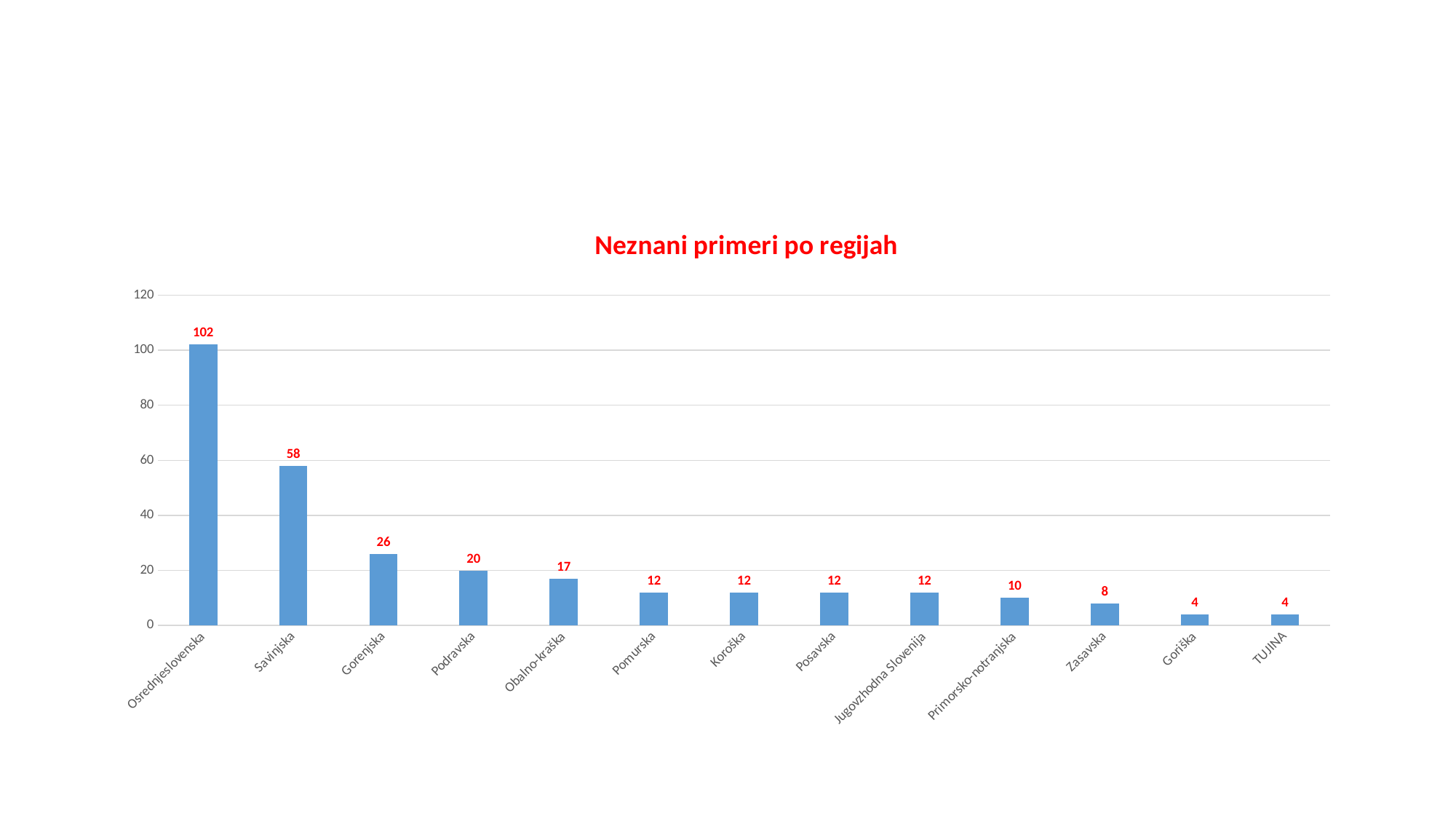
What is the value for Obalno-kraška? 17 Which region has the highest value? Osrednjeslovenska What is the value for Zasavska? 8 What is the title of the chart? Neznani primeri po regijah What is the value for Osrednjeslovenska? 102 What is the difference between the values for Gorenjska and Podravska? 6 What is the value for Savinjska? 58 What kind of chart is shown on the slide? Bar chart Do the values rise or fall from left to right along the x axis? Fall Which is larger, the value for Primorsko-notranjska or the value for Zasavska? Primorsko-notranjska How many categories are shown on the x axis? 13 What is the difference between the values for Osrednjeslovenska and Savinjska? 44